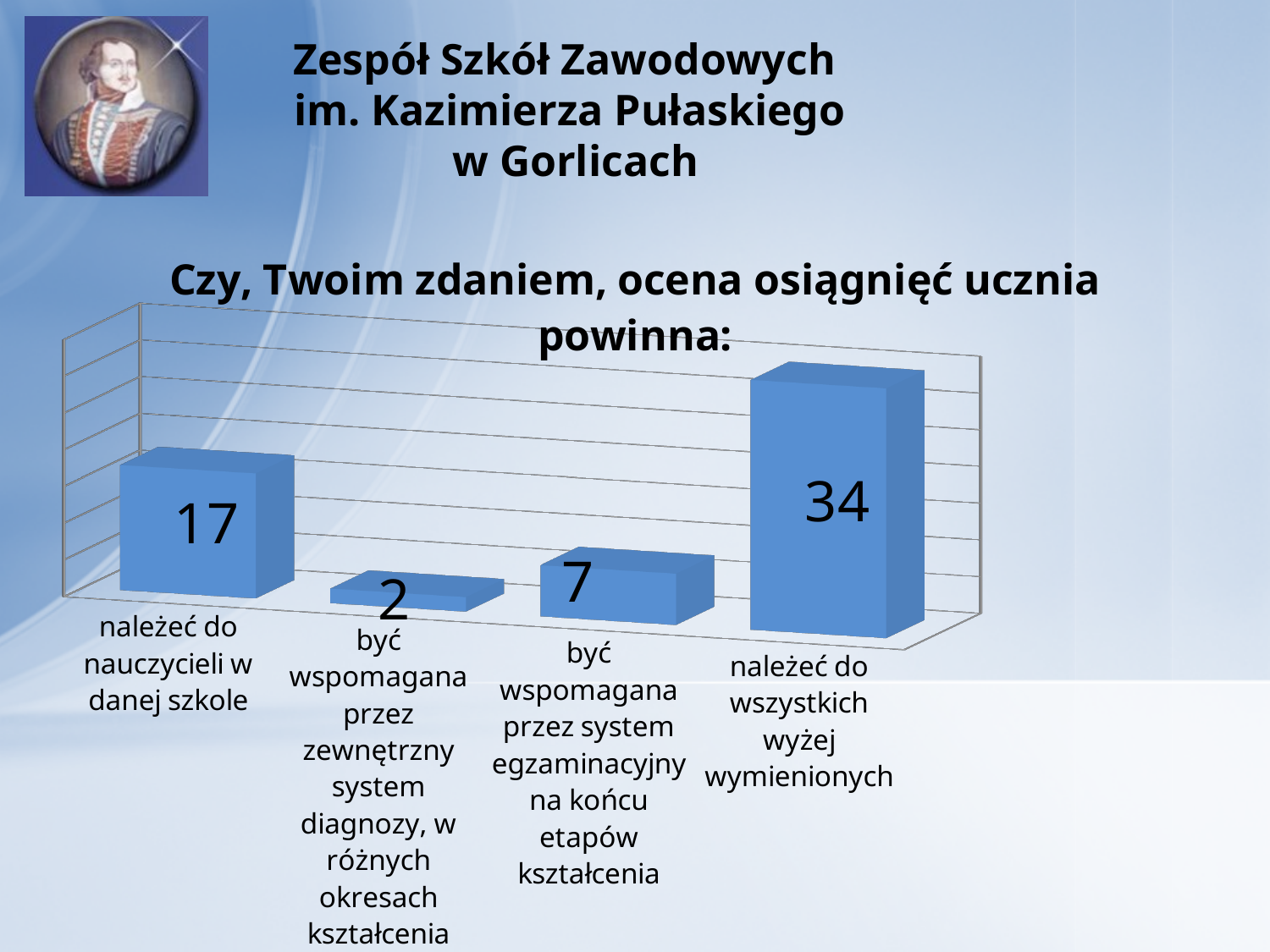
What is the value for "być wspomagana przez system egzaminacyjny na końcu etapów kształcenia"? 7 What is the difference between the values for "należeć do wszystkich wyżej wymienionych" and "należeć do nauczycieli w danej szkole"? 17 What is the value for "należeć do nauczycieli w danej szkole"? 17 How many categories are shown in the chart? 4 What kind of chart is shown on the slide? bar chart Which is larger: the value for "należeć do nauczycieli w danej szkole" or the value for "być wspomagana przez system egzaminacyjny na końcu etapów kształcenia"? należeć do nauczycieli w danej szkole What is the value for "być wspomagana przez zewnętrzny system diagnozy, w różnych okresach kształcenia"? 2 What is the difference between the values for "być wspomagana przez system egzaminacyjny na końcu etapów kształcenia" and "być wspomagana przez zewnętrzny system diagnozy, w różnych okresach kształcenia"? 5 Which category has the highest value? należeć do wszystkich wyżej wymienionych What is the title of the chart? Czy, Twoim zdaniem, ocena osiągnięć ucznia powinna: What is the value for "należeć do wszystkich wyżej wymienionych"? 34 Which category has the lowest value? być wspomagana przez zewnętrzny system diagnozy, w różnych okresach kształcenia